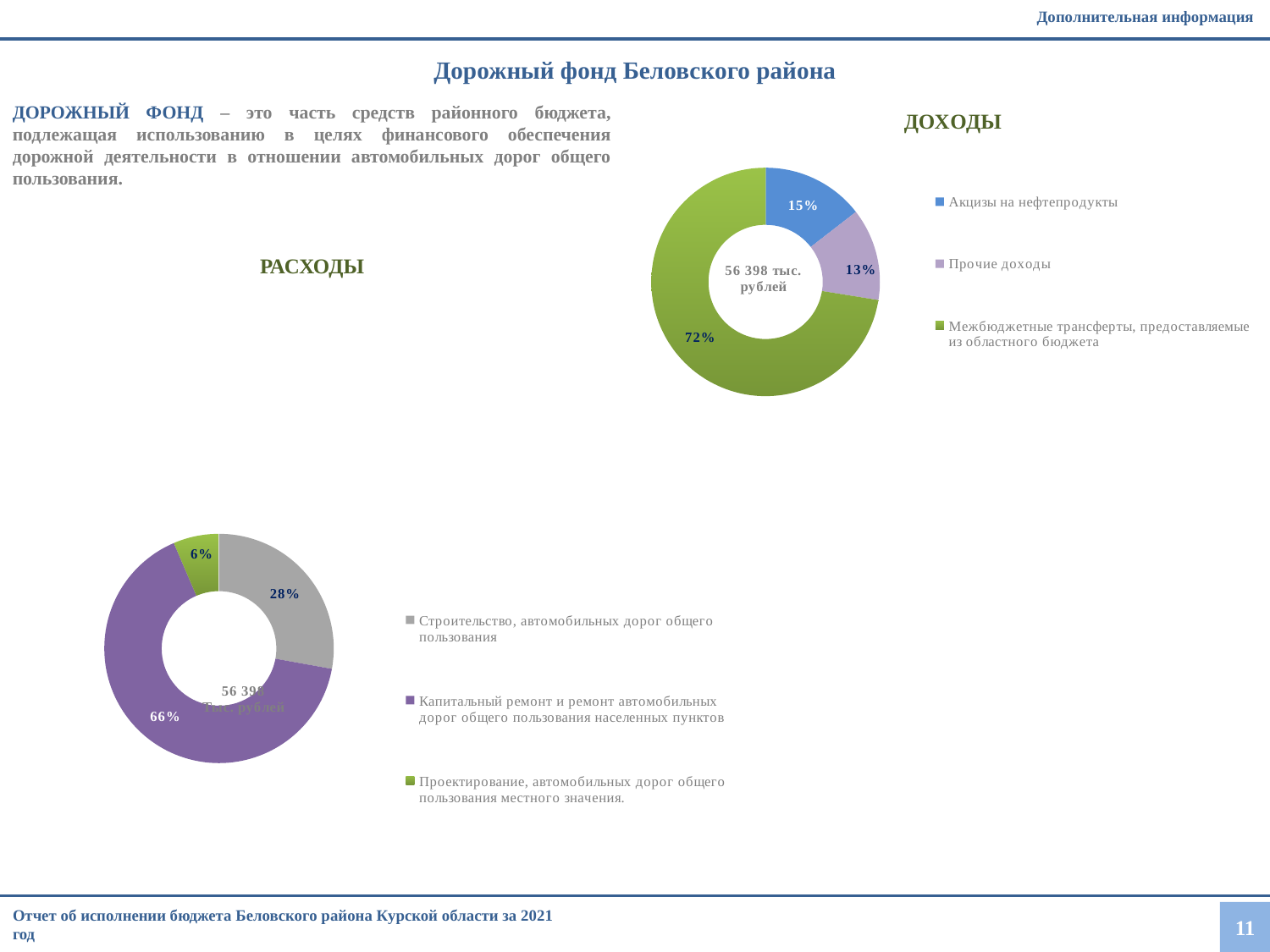
In the ДОХОДЫ chart, what share is labelled for Прочие доходы? 13% In the ДОХОДЫ chart, which category has the largest share? Межбюджетные трансферты, предоставляемые из областного бюджета What type of chart is used for РАСХОДЫ? Pie (doughnut) chart In the ДОХОДЫ chart, what is the difference in percentage points between Межбюджетные трансферты and Акцизы на нефтепродукты? 57 In the ДОХОДЫ chart, what share is labelled for Акцизы на нефтепродукты? 15% In the ДОХОДЫ chart, which category has the smallest share? Прочие доходы In the РАСХОДЫ chart, what share is labelled for Проектирование, автомобильных дорог общего пользования местного значения? 6% In the РАСХОДЫ chart, what share is labelled for Капитальный ремонт и ремонт автомобильных дорог общего пользования населенных пунктов? 66% In the РАСХОДЫ chart, which is larger: Строительство or Проектирование? Строительство In the РАСХОДЫ chart, which category has the largest share? Капитальный ремонт и ремонт автомобильных дорог общего пользования населенных пунктов What total value is shown in the centre of the ДОХОДЫ chart? 56 398 тыс. рублей How many categories does the legend of the ДОХОДЫ chart list? 3